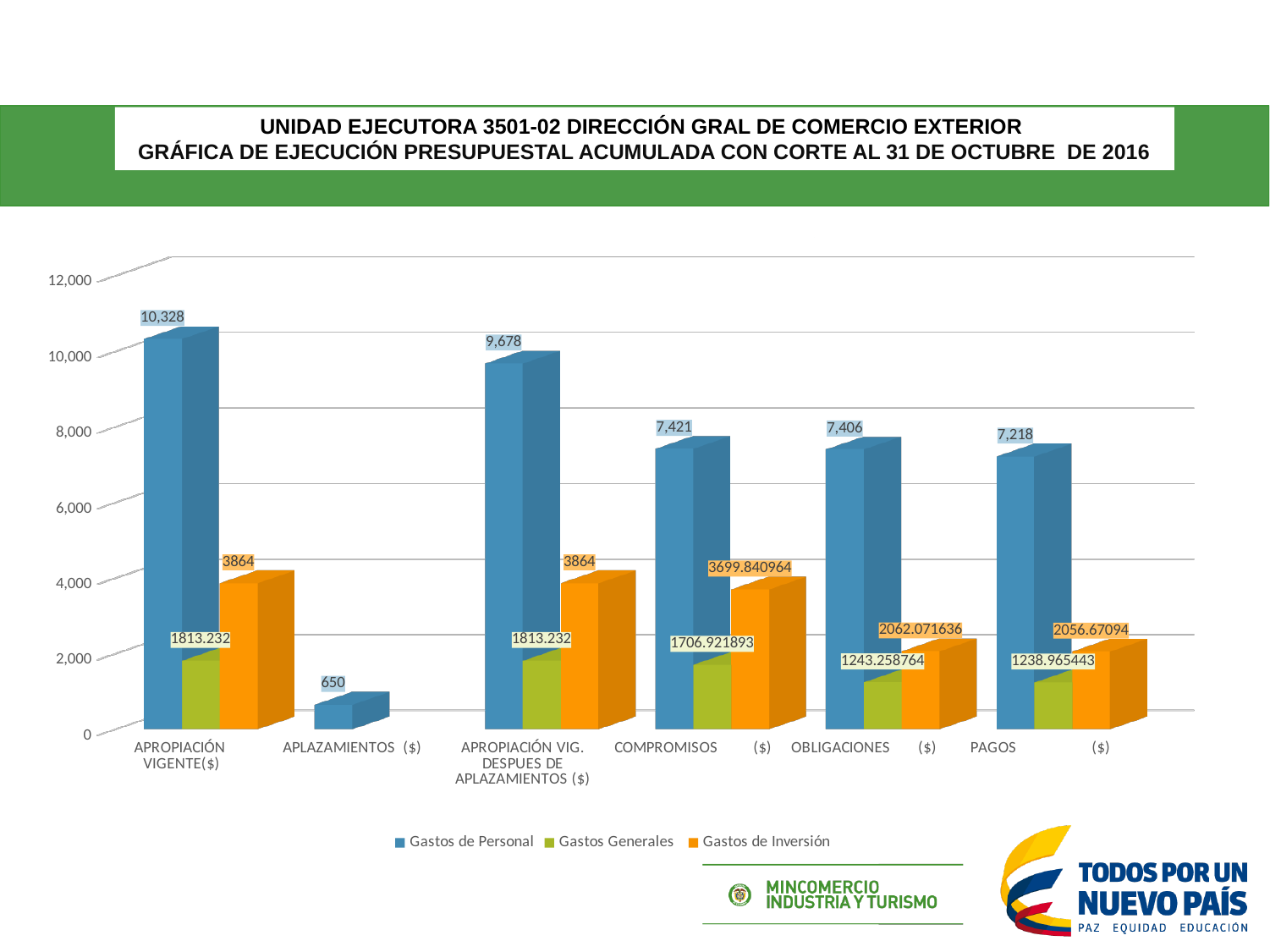
What is the difference between the Gastos de Personal values for APROPIACIÓN VIGENTE($) and APROPIACIÓN VIG. DESPUES DE APLAZAMIENTOS ($)? 650 How many series does the legend list? 3 What is the value of Gastos de Personal for APLAZAMIENTOS ($)? 650 How many categories are shown on the x axis of the chart? 6 What is the value of Gastos Generales for PAGOS ($)? 1238.965443 What kind of chart is shown on the slide? Bar chart Which has the larger Gastos de Personal value, OBLIGACIONES ($) or PAGOS ($)? OBLIGACIONES ($) What is the value of Gastos de Inversión for COMPROMISOS ($)? 3699.840964 Is the value of Gastos Generales for OBLIGACIONES ($) greater or less than 2,000? less Which category has the lowest value for Gastos de Personal? APLAZAMIENTOS ($) What is the value of Gastos de Personal for APROPIACIÓN VIGENTE($)? 10,328 Which category has the highest value for Gastos de Personal? APROPIACIÓN VIGENTE($)